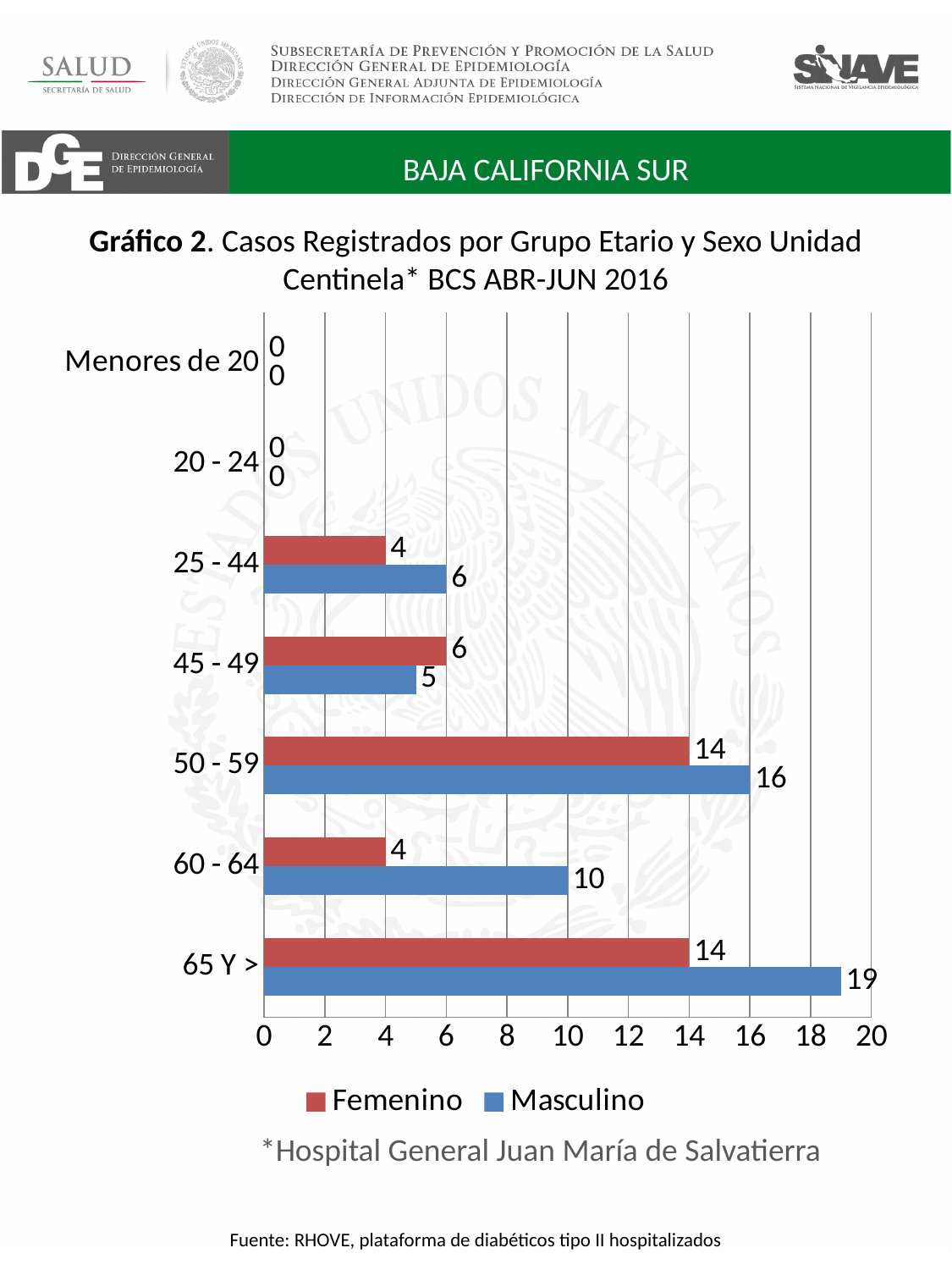
What is the Femenino value for the 50 - 59 age group? 14 Is the Femenino value for 45 - 49 larger or smaller than the Masculino value for 45 - 49? larger Which colour represents the Masculino series? blue What is the difference between the Masculino values for 65 Y > and 50 - 59? 3 What kind of chart is shown? bar chart What is the Masculino value for the 65 Y > age group? 19 Which age group has the highest Femenino value among those with non-zero values, 25 - 44 or 45 - 49? 45 - 49 How many series does the legend list? 2 What is the difference between the Masculino and Femenino values for the 60 - 64 age group? 6 Which age group has the highest Masculino value? 65 Y > How many age groups are shown on the chart? 7 What is the Masculino value for the 60 - 64 age group? 10